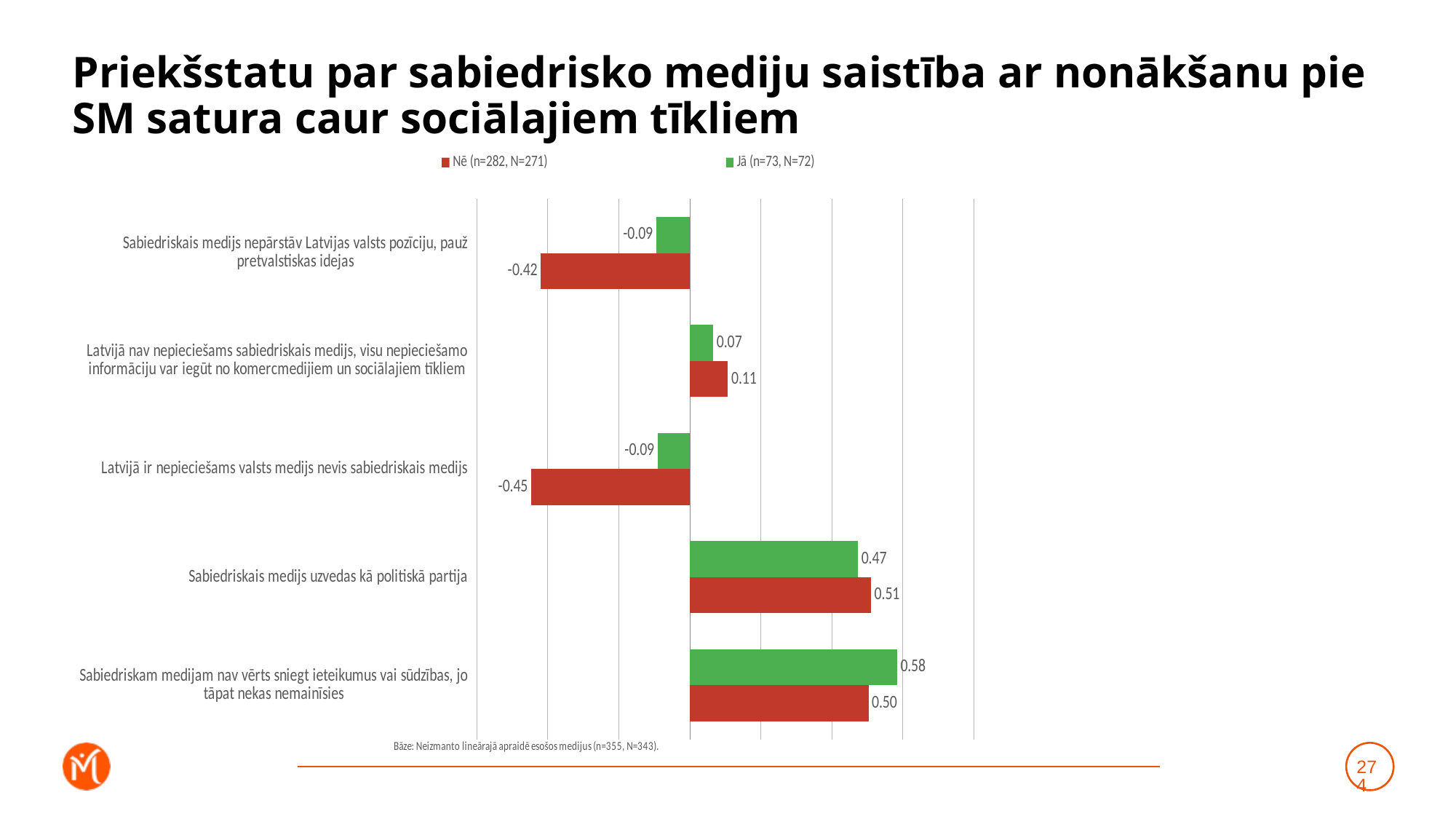
How many categories are shown in the chart? 5 Which colour represents the Jā (n=73, N=72) series? Green What is the value of the Nē series for "Latvijā ir nepieciešams valsts medijs nevis sabiedriskais medijs"? -0.45 Which category has the highest value in the Jā series? Sabiedriskam medijam nav vērts sniegt ieteikumus vai sūdzības, jo tāpat nekas nemainīsies What is the difference between the Nē and Jā values for "Sabiedriskais medijs nepārstāv Latvijas valsts pozīciju, pauž pretvalstiskas idejas"? 0.33 What type of chart is shown on the slide? Bar chart For "Sabiedriskam medijam nav vērts sniegt ieteikumus vai sūdzības, jo tāpat nekas nemainīsies", which series has the larger value, Nē or Jā? Jā Which category has the lowest value in the Nē series? Latvijā ir nepieciešams valsts medijs nevis sabiedriskais medijs What is the value of the Jā series for "Sabiedriskam medijam nav vērts sniegt ieteikumus vai sūdzības, jo tāpat nekas nemainīsies"? 0.58 What is the value of the Nē series for "Sabiedriskais medijs uzvedas kā politiskā partija"? 0.51 What is the value of the Jā series for "Latvijā nav nepieciešams sabiedriskais medijs, visu nepieciešamo informāciju var iegūt no komercmedijiem un sociālajiem tīkliem"? 0.07 How many series does the legend list? 2